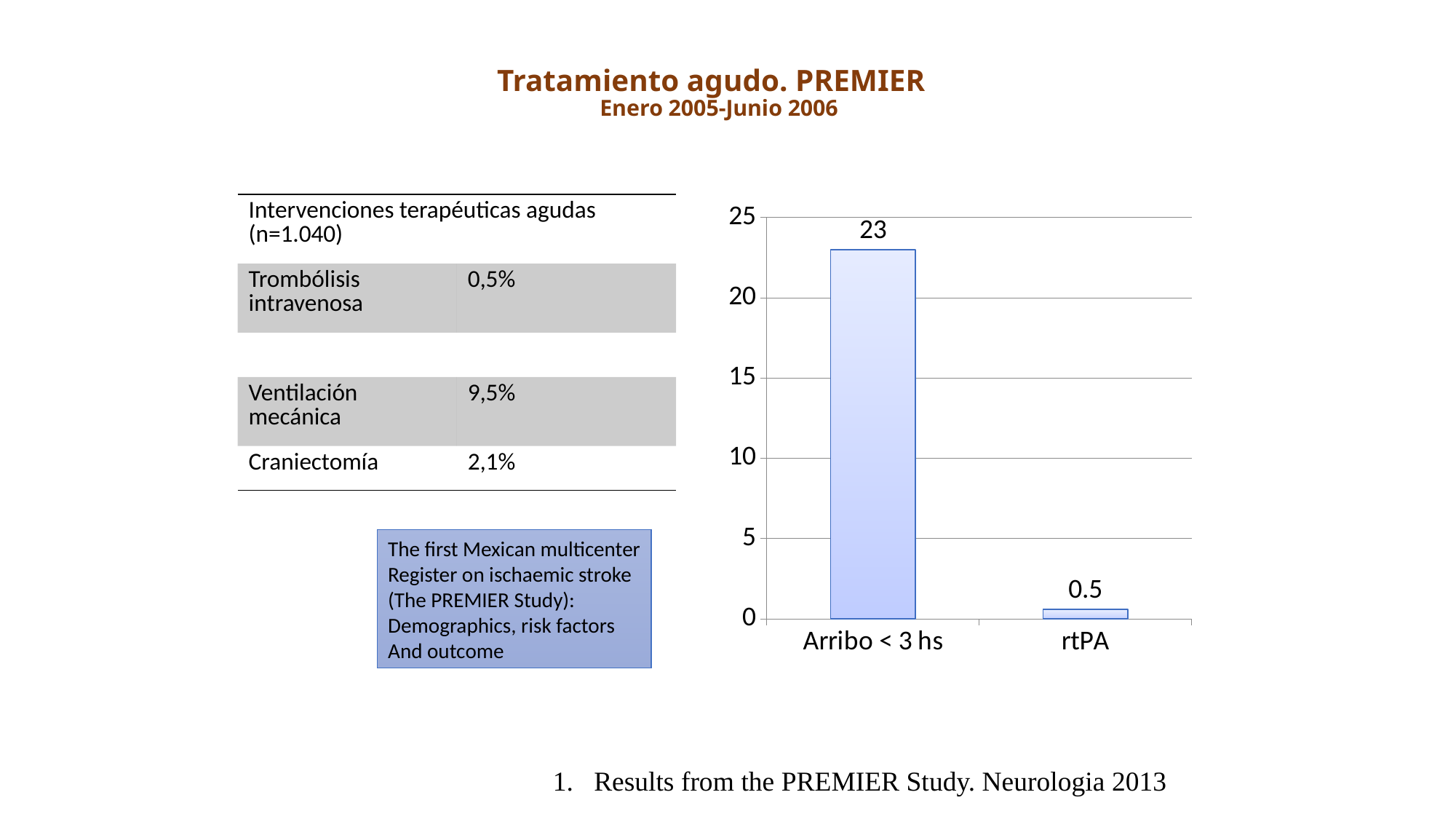
What is the value for Arribo < 3 hs? 23 What is the value for rtPA? 0.5 Which is larger, the value for Arribo < 3 hs or the value for rtPA? Arribo < 3 hs What is the difference between the values for Arribo < 3 hs and rtPA? 22.5 Which category has the highest value? Arribo < 3 hs Which category has the lowest value? rtPA Is the value for Arribo < 3 hs greater or less than 20? greater Is the value for rtPA greater or less than 5? less What is the maximum value shown on the chart's vertical axis? 25 What is the label of the first category on the x axis? Arribo < 3 hs What kind of chart is shown on the slide? bar chart How many categories are shown on the chart? 2